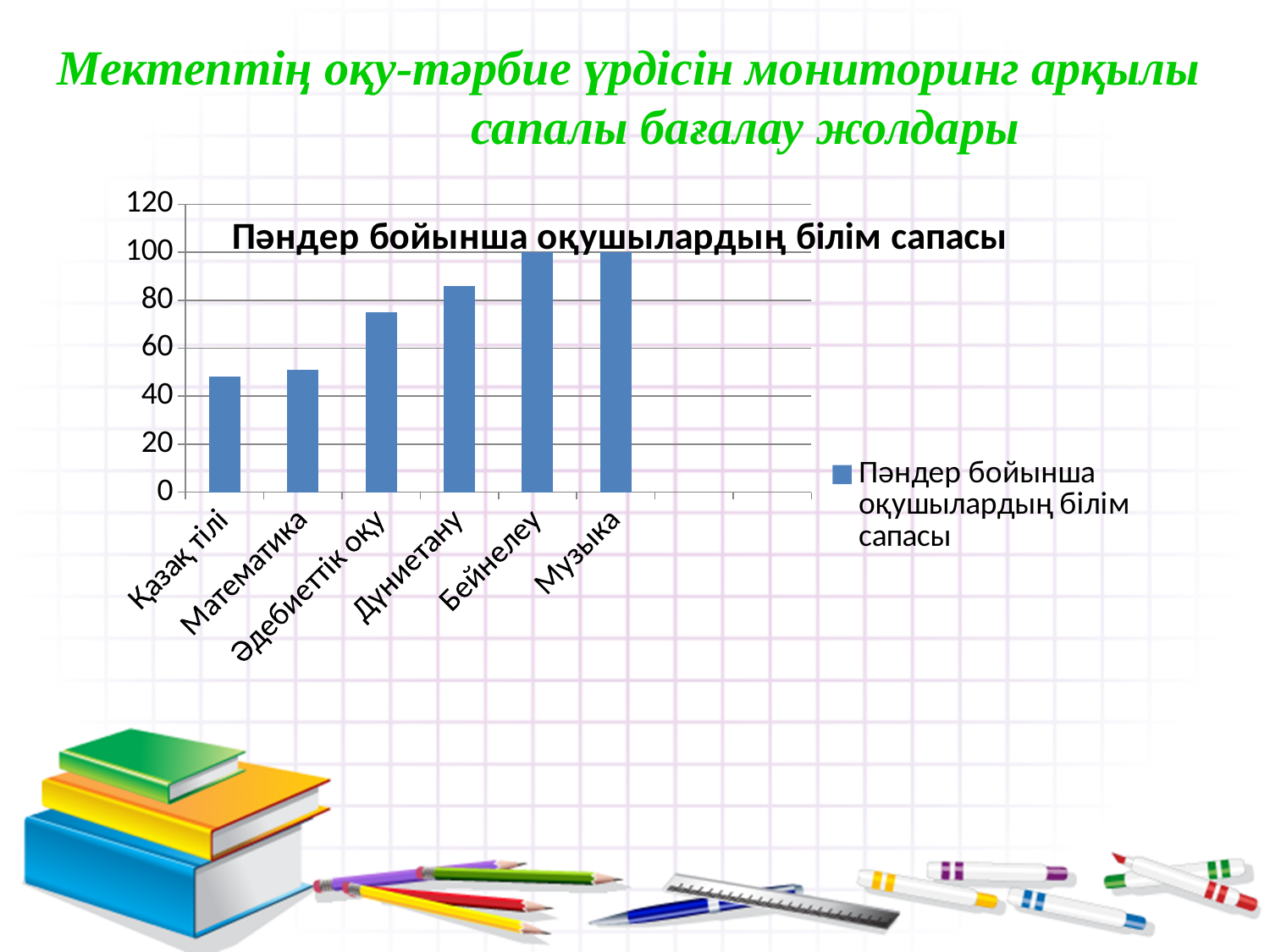
What kind of chart is shown on the slide? bar chart How many series does the legend list? 1 What is the title of the chart? Пәндер бойынша оқушылардың білім сапасы How many categories (subjects) are plotted on the chart? 6 Is the value for Математика greater or less than 60? less Is the value for Әдебиеттік оқу greater or less than 60? greater Do the values generally rise or fall from left to right along the x axis? rise Is the value for Дүниетану greater or less than 80? greater Which is larger, the value for Музыка or the value for Қазақ тілі? Музыка What is the legend entry shown on the chart? Пәндер бойынша оқушылардың білім сапасы Which is larger, the value for Дүниетану or the value for Әдебиеттік оқу? Дүниетану